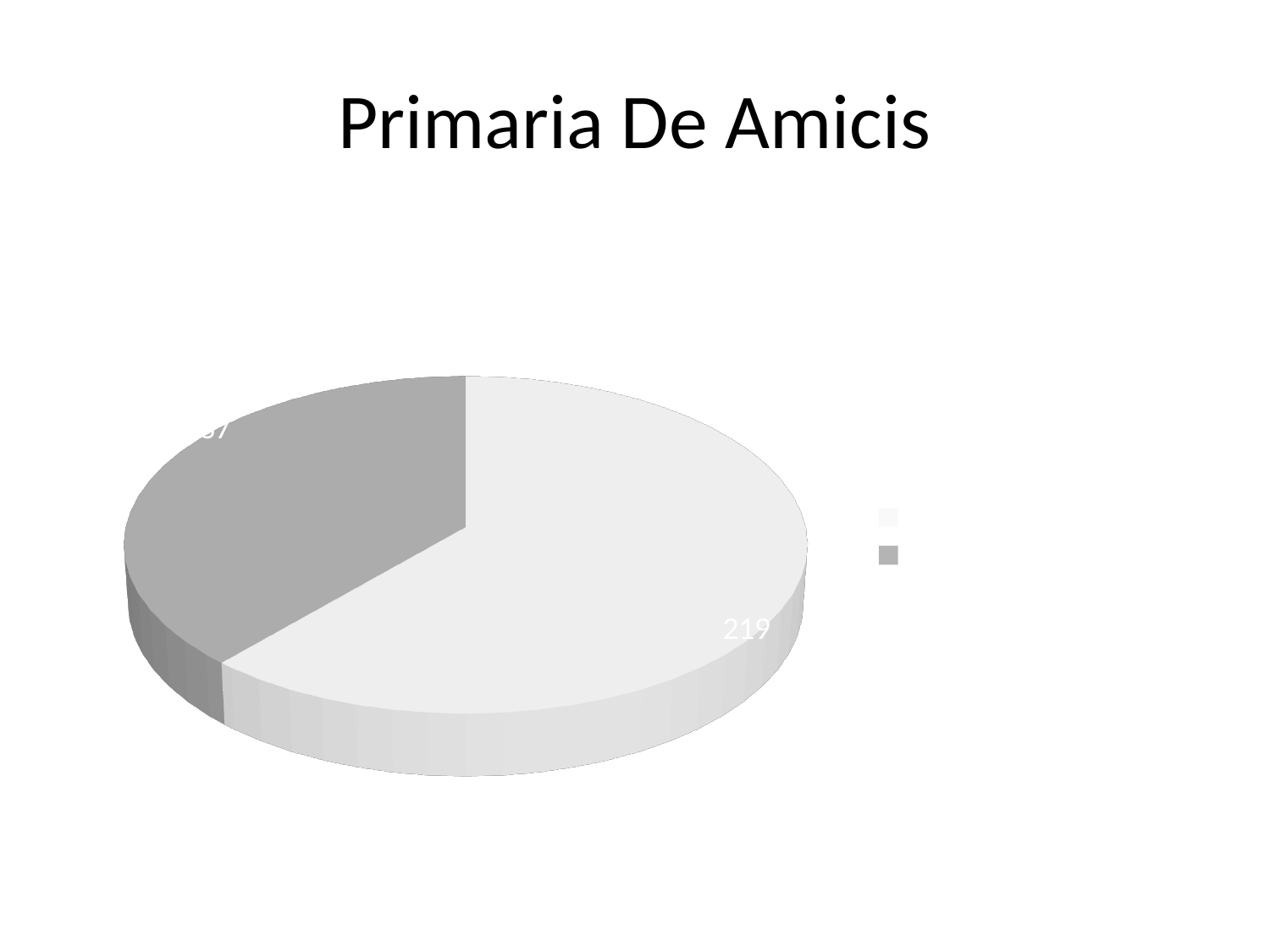
What kind of chart is shown on the slide? pie chart Does the light grey slice make up more or less than half of the pie? more How many slices does the pie chart have? 2 How many entries does the legend list? 2 Which slice is larger, the light grey one or the dark grey one? the light grey one What is the title of the chart? Primaria De Amicis Which slice of the pie is the smallest? the dark grey slice What value is labelled on the light grey slice of the pie? 219 Which slice of the pie is the largest? the light grey slice (219)